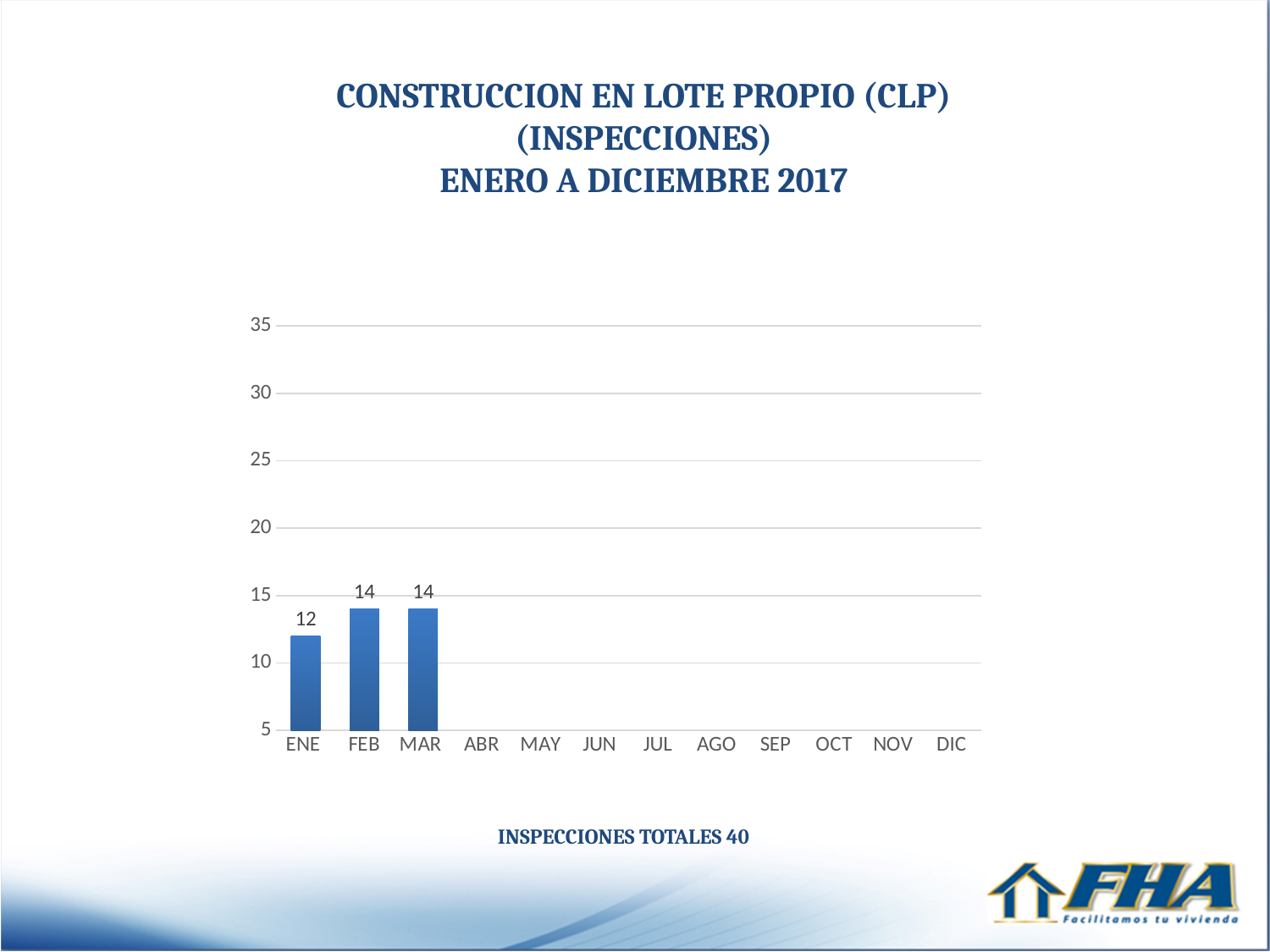
What total number of inspections is stated below the chart? 40 What is the value for MAR? 14 What is the difference between the values for FEB and ENE? 2 Which is larger, the value for ENE or the value for MAR? MAR What is the value for ENE? 12 What kind of chart is shown on the slide? bar chart Is the value for FEB greater or less than 15? less What is the value for FEB? 14 Which month has the lowest value among the months with bars shown? ENE How many month categories are shown on the x axis? 12 Is the value for ENE greater or less than 10? greater How many months have a visible bar in the chart? 3